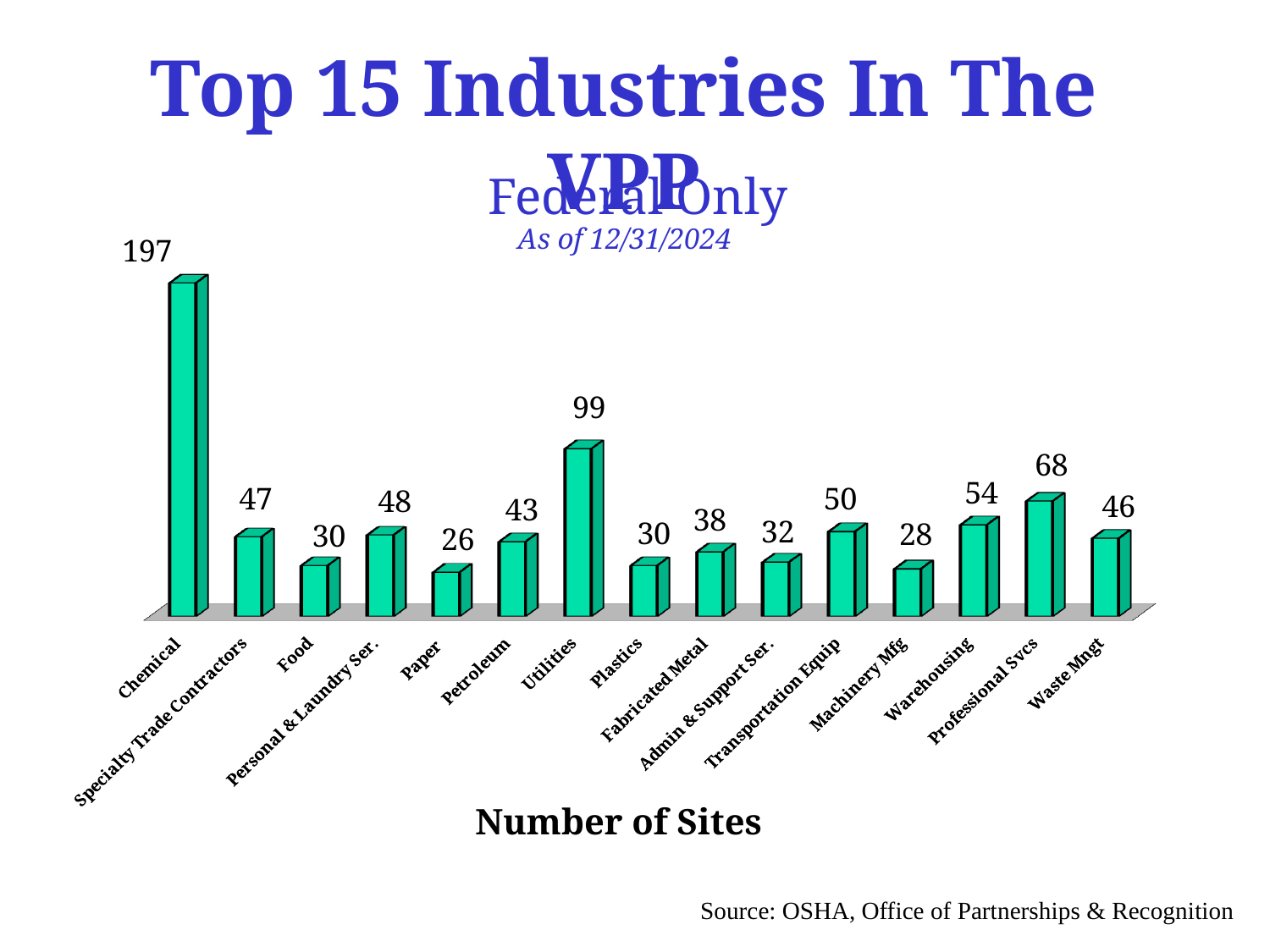
Which has more sites, Transportation Equip or Petroleum? Transportation Equip How many industries are shown in the chart? 15 How many sites does the Chemical industry have? 197 Which has more sites, Specialty Trade Contractors or Personal & Laundry Ser.? Personal & Laundry Ser. How many more sites does Warehousing have than Machinery Mfg? 26 What is the number of sites for Utilities? 99 What is the value shown for Professional Svcs? 68 What type of chart is shown on the slide? Bar chart Which industry has the lowest number of sites? Paper What is the difference in number of sites between Chemical and Utilities? 98 What is the label shown below the category axis of the chart? Number of Sites Which industry has the highest number of sites? Chemical